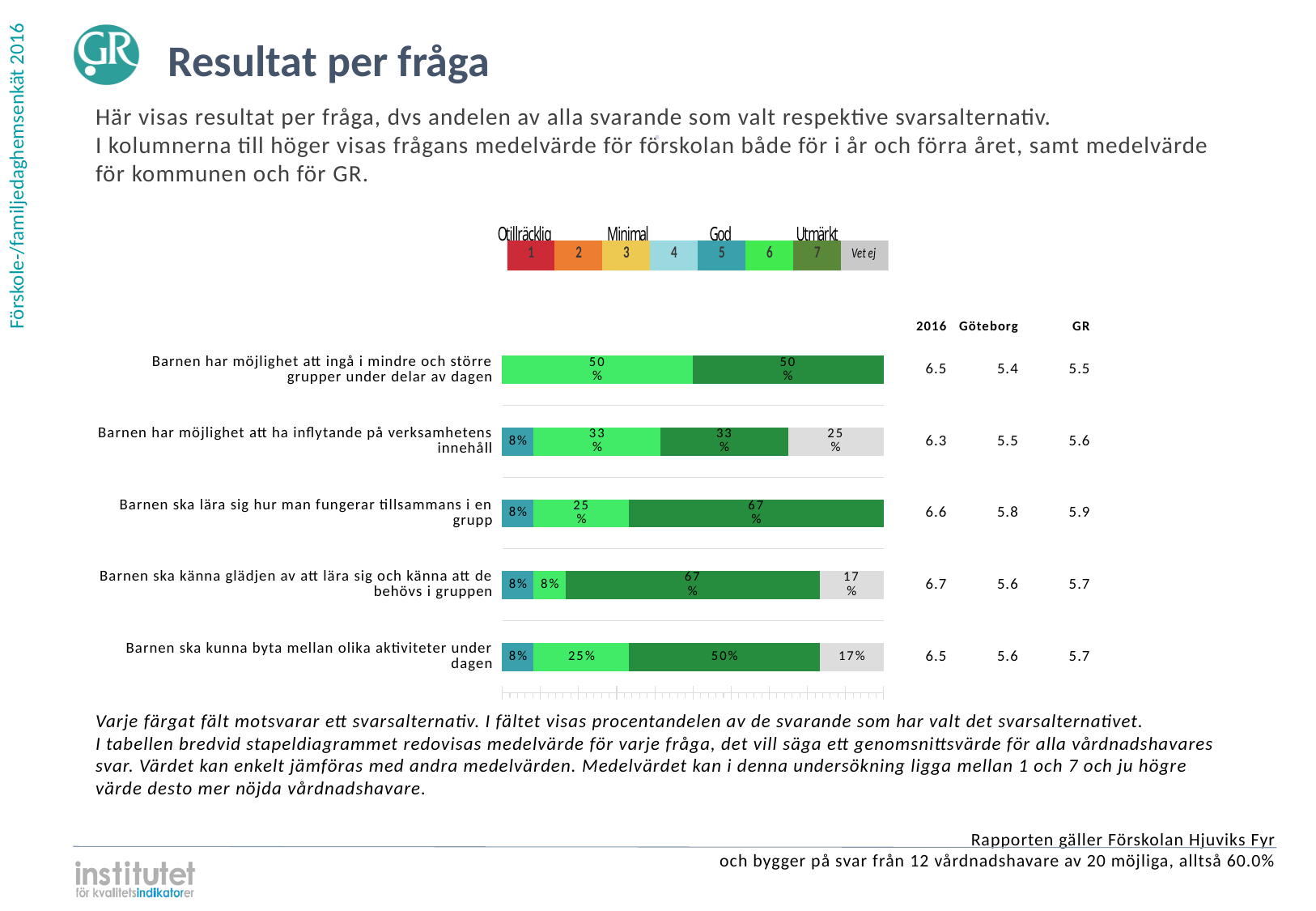
What percentage of respondents chose answer 7 for 'Barnen ska lära sig hur man fungerar tillsammans i en grupp'? 67% Which question has the lowest 2016 mean value? Barnen har möjlighet att ha inflytande på verksamhetens innehåll What is the 2016 mean value for 'Barnen ska känna glädjen av att lära sig och känna att de behövs i gruppen'? 6.7 What is the GR mean value for 'Barnen ska lära sig hur man fungerar tillsammans i en grupp'? 5.9 For 'Barnen ska kunna byta mellan olika aktiviteter under dagen', what is the difference in percentage points between the share choosing 7 and the share choosing 6? 25 How many questions (categories) are shown in the bar chart? 5 Is the 2016 mean for 'Barnen ska lära sig hur man fungerar tillsammans i en grupp' larger or smaller than its Göteborg mean? Larger Which answer alternative does the dark green colour in the legend represent? 7 Which question has the highest 2016 mean value? Barnen ska känna glädjen av att lära sig och känna att de behövs i gruppen What percentage chose 'Vet ej' for 'Barnen har möjlighet att ha inflytande på verksamhetens innehåll'? 25% How many answer alternatives does the legend above the chart list? 8 What kind of chart is used to show the results per question? Stacked bar chart